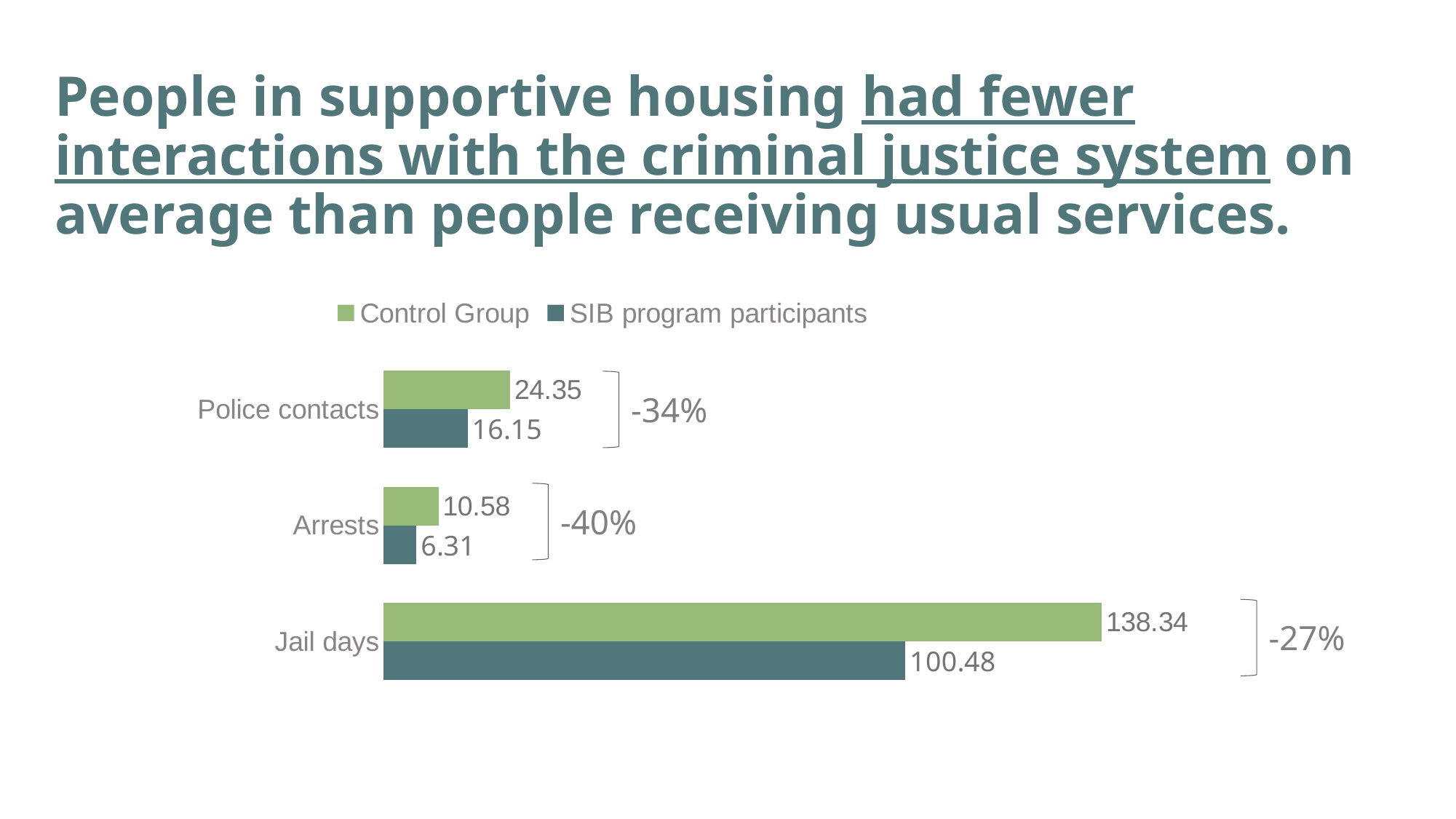
How many series does the legend list? 2 Which category has the highest Control Group value? Jail days How many categories are shown on the chart? 3 What is the difference between the Control Group and SIB program participants values for Police contacts? 8.20 What is the difference between the Control Group and SIB program participants values for Jail days? 37.86 What is the SIB program participants value for Arrests? 6.31 What kind of chart is shown on the slide? Bar chart What percentage change is annotated next to the Arrests bars? -40% What is the SIB program participants value for Jail days? 100.48 What is the Control Group value for Police contacts? 24.35 For Arrests, which is larger: the Control Group value or the SIB program participants value? Control Group Which category has the lowest SIB program participants value? Arrests